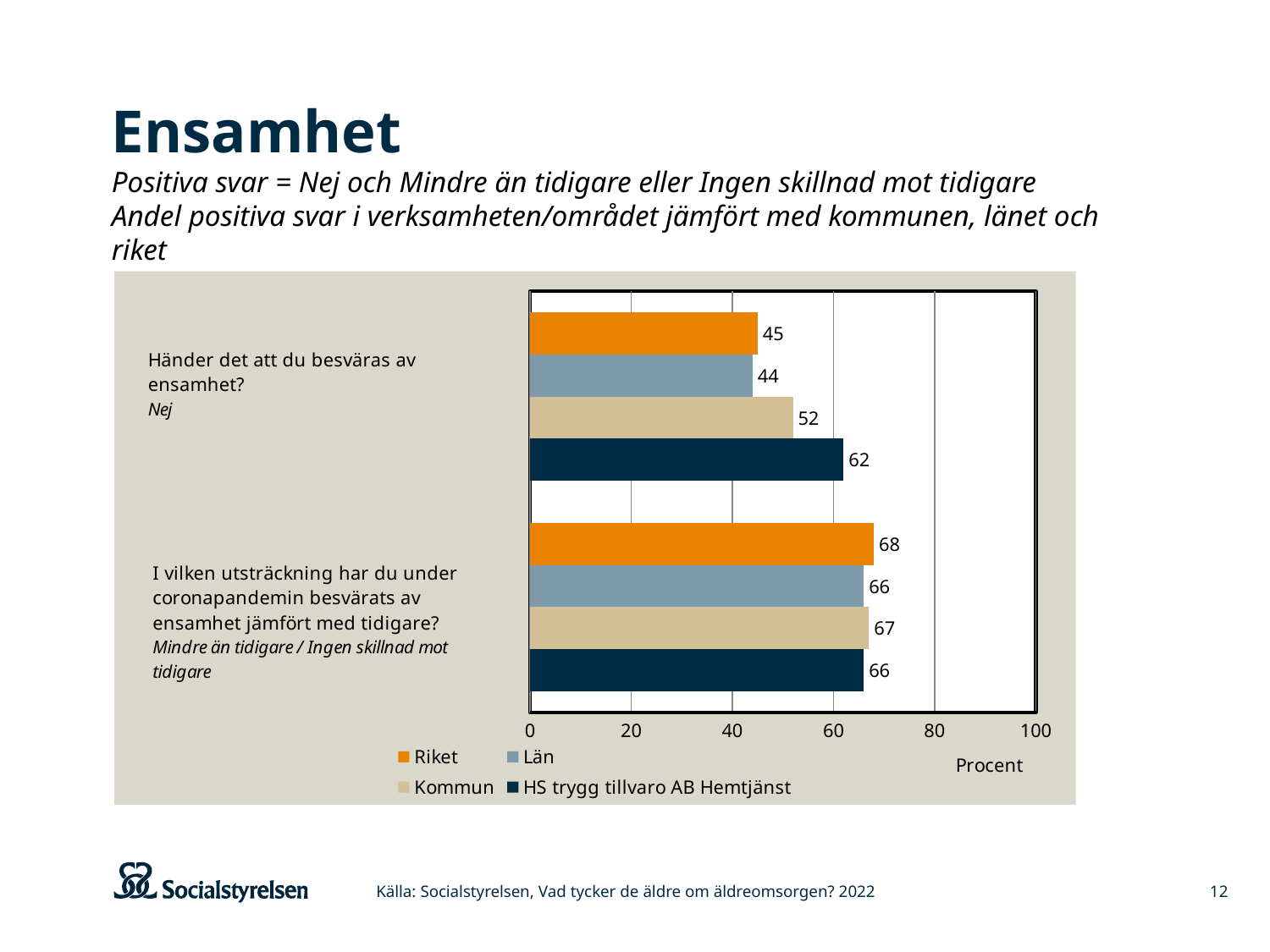
What is the value for HS trygg tillvaro AB Hemtjänst for the question 'Händer det att du besväras av ensamhet?' 62 What unit is shown on the horizontal axis of the chart? Procent What is the difference between the HS trygg tillvaro AB Hemtjänst value and the Riket value for the question 'Händer det att du besväras av ensamhet?' 17 What is the value for Riket for the question 'Händer det att du besväras av ensamhet?' 45 What is the value for Län for the question 'I vilken utsträckning har du under coronapandemin besvärats av ensamhet jämfört med tidigare?' 66 For the question 'Händer det att du besväras av ensamhet?', which is larger: the Kommun value or the Riket value? Kommun Which series has the highest value for the question 'Händer det att du besväras av ensamhet?' HS trygg tillvaro AB Hemtjänst How many series does the legend list? 4 Which series has the lowest value for the question 'Händer det att du besväras av ensamhet?' Län What is the value for Kommun for the question 'I vilken utsträckning har du under coronapandemin besvärats av ensamhet jämfört med tidigare?' 67 Is the Riket value for the question 'I vilken utsträckning har du under coronapandemin besvärats av ensamhet jämfört med tidigare?' greater or less than 60? greater What kind of chart is shown on the slide? Bar chart